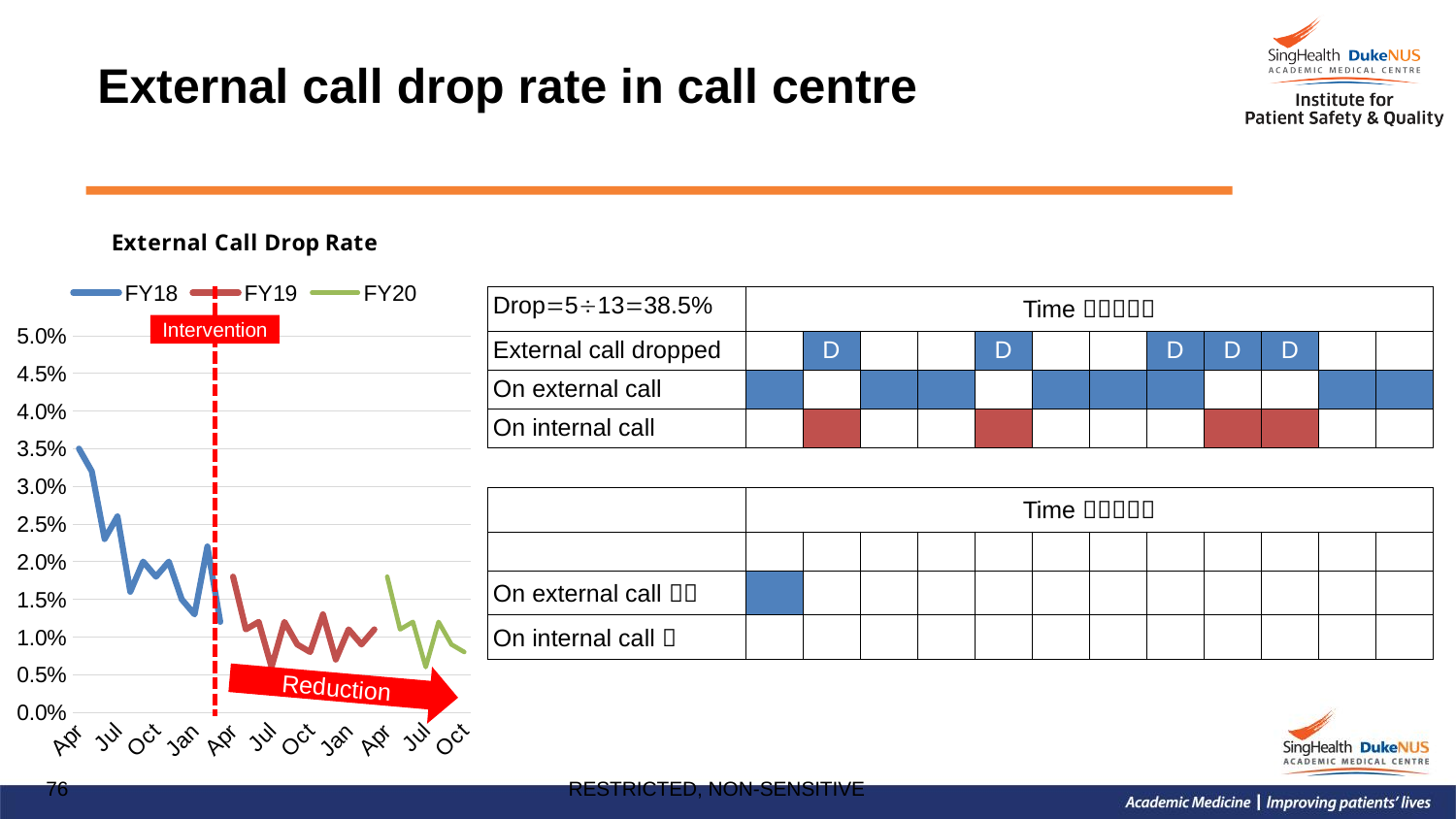
What is the highest value shown on the y axis of the External Call Drop Rate chart? 5.0% In the External Call Drop Rate chart, is the last FY18 value (Apr) greater or less than 1.5%? less In the External Call Drop Rate chart, does the FY18 line rise or fall from Apr to the following Apr? fall In the External Call Drop Rate chart, are the FY19 values greater or less than 2.5%? less How many series does the legend of the External Call Drop Rate chart list? 3 In the External Call Drop Rate chart, which series reaches the highest drop rate? FY18 In the External Call Drop Rate chart, are the FY20 values greater or less than 2.0%? less In the External Call Drop Rate chart, which is larger: the first FY18 value or the first FY20 value? the first FY18 value Which series are listed in the legend of the External Call Drop Rate chart? FY18, FY19, FY20 What kind of chart is shown under the title "External Call Drop Rate"? line chart